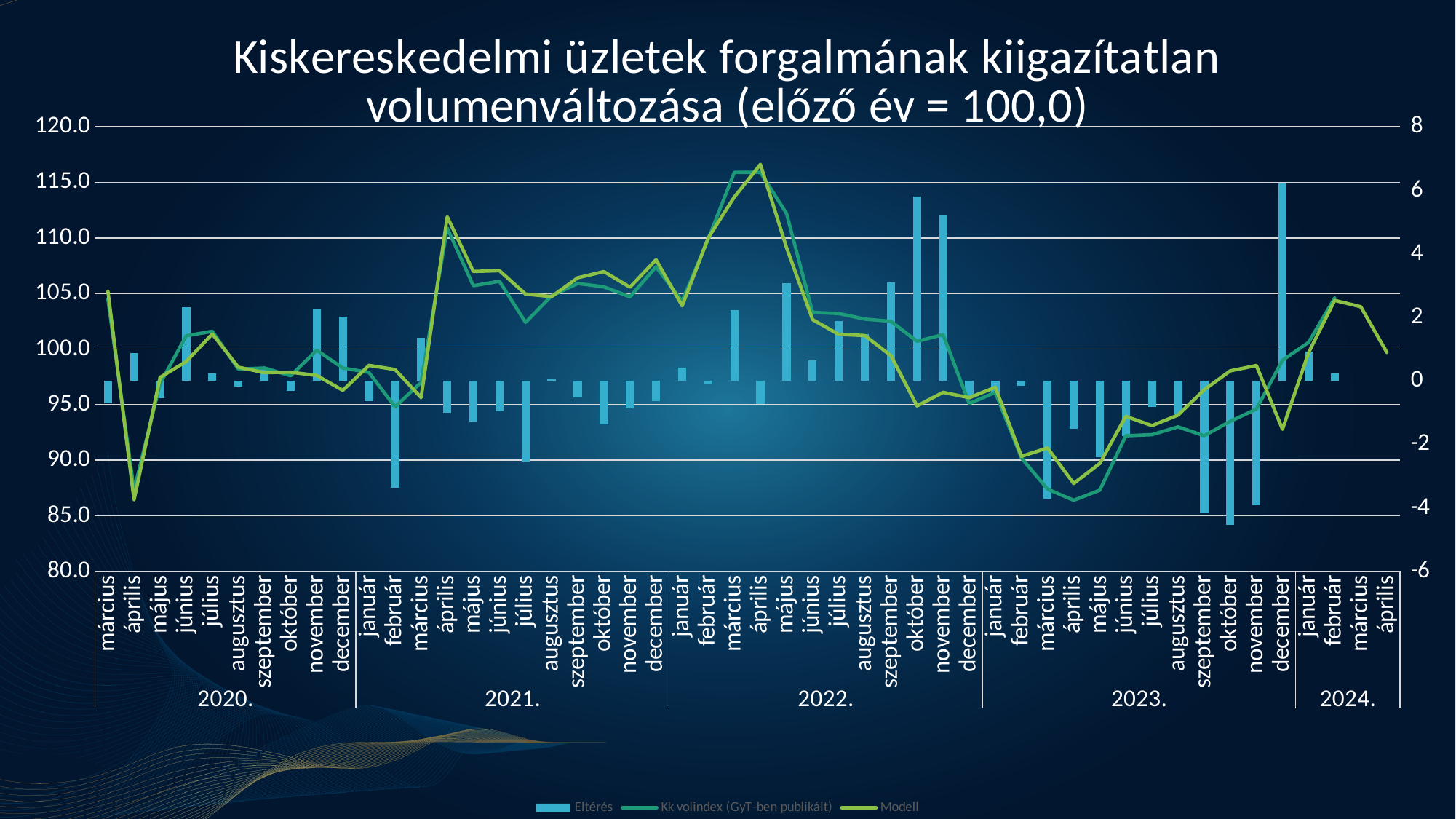
Does the Kk volindex line rise or fall from április 2022 to július 2022? fall What are the names of the series in the legend? Eltérés, Kk volindex (GyT-ben publikált), Modell Is the Modell value for április 2021 greater or less than 110.0? greater How many series does the legend list? 3 Which years are shown along the x axis? 2020, 2021, 2022, 2023, 2024 Is the Eltérés bar for december 2023 greater or less than 4 on the right axis? greater Which month has the highest Modell value, április 2021 or április 2022? április 2022 Is the Kk volindex value for április 2022 greater or less than 110.0? greater What kind of chart is shown on the slide? A combination of a bar chart and line charts